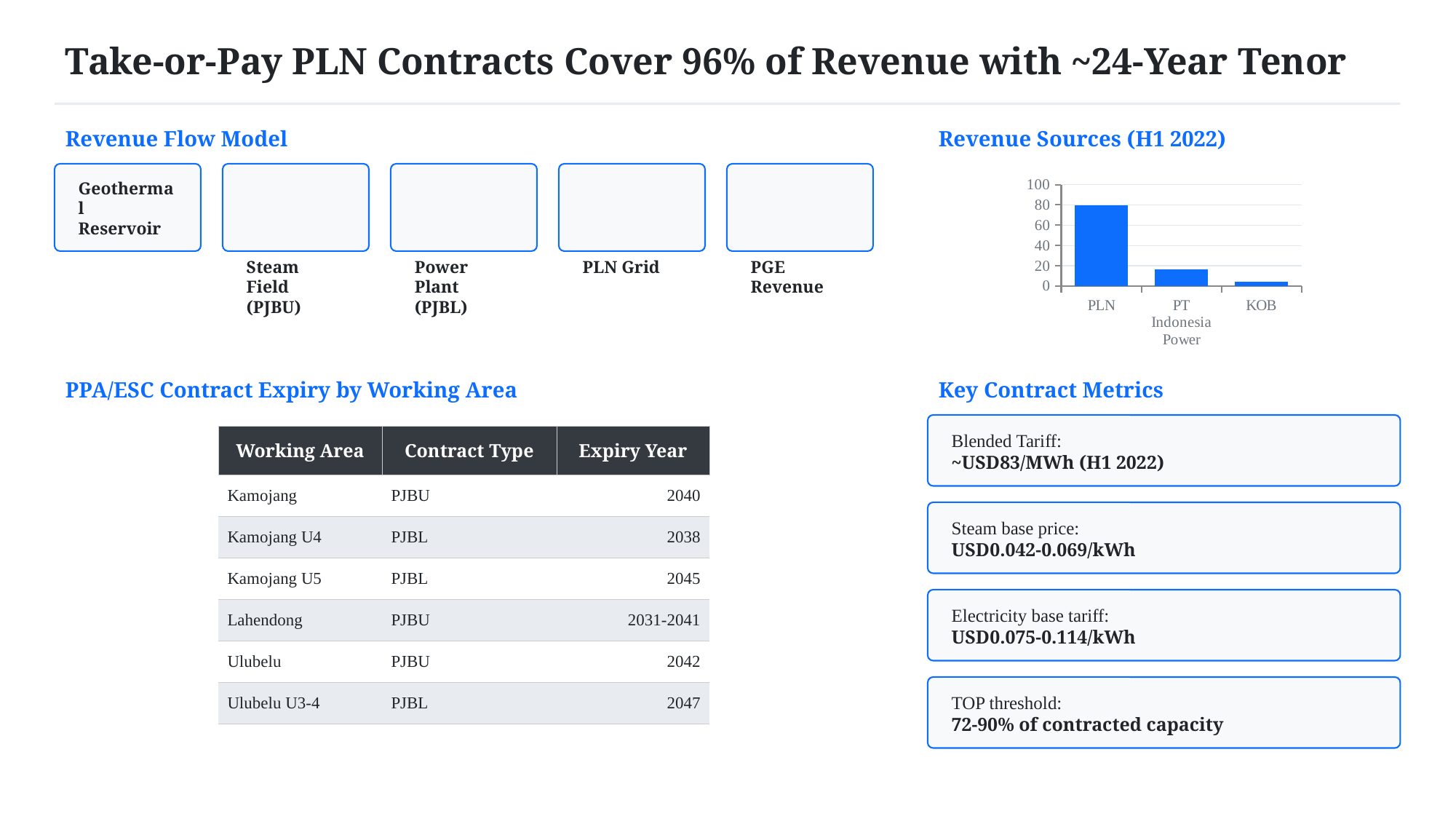
In the Revenue Sources (H1 2022) chart, which category has the highest value? PLN What is the title of the bar chart on the slide? Revenue Sources (H1 2022) What kind of chart is shown under "Revenue Sources (H1 2022)"? bar chart In the Revenue Sources (H1 2022) chart, is the value for PT Indonesia Power greater or less than 40? less What is the highest value shown on the vertical axis of the Revenue Sources (H1 2022) chart? 100 In the Revenue Sources (H1 2022) chart, is the value for KOB greater or less than 20? less In the Revenue Sources (H1 2022) chart, is the value for PLN greater or less than 60? greater How many categories are plotted in the Revenue Sources (H1 2022) chart? 3 In the Revenue Sources (H1 2022) chart, do the values rise or fall from left to right along the x axis? fall In the Revenue Sources (H1 2022) chart, which category has the lowest value? KOB In the Revenue Sources (H1 2022) chart, which is larger: PT Indonesia Power or KOB? PT Indonesia Power